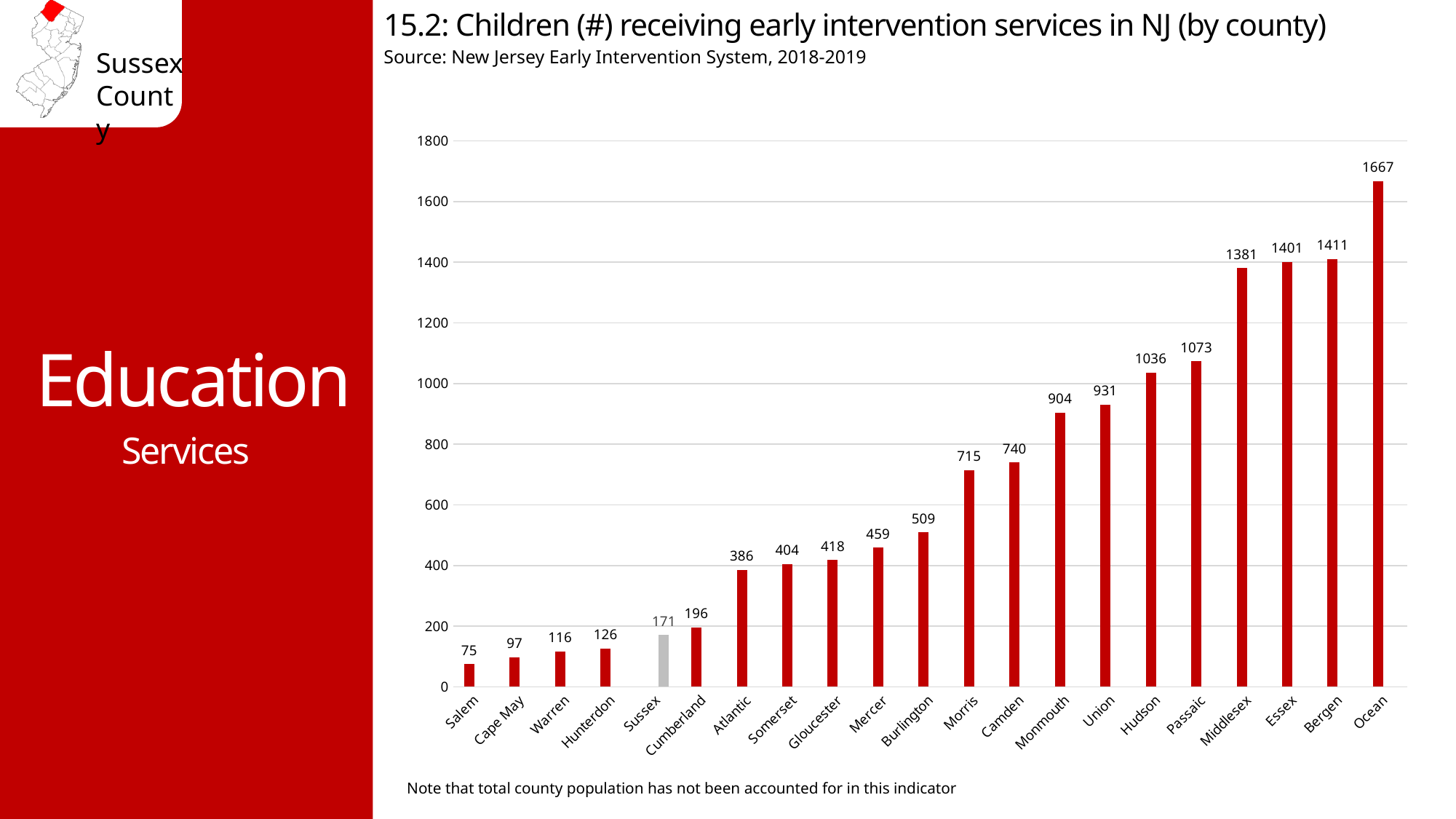
Which county has the highest number of children receiving early intervention services? Ocean How many counties are shown on the chart? 21 What is the difference between the values for Bergen and Essex? 10 What is the value shown for Hudson County? 1036 Which has a larger value, Morris or Camden? Camden Which county has the lowest number of children receiving early intervention services? Salem How many children received early intervention services in Sussex County? 171 Which county's bar is coloured grey instead of red? Sussex What is the value shown for Ocean County? 1667 What kind of chart is shown on the slide? bar chart Is the value for Monmouth greater or less than 1000? less What is the difference between the values for Cumberland and Sussex? 25